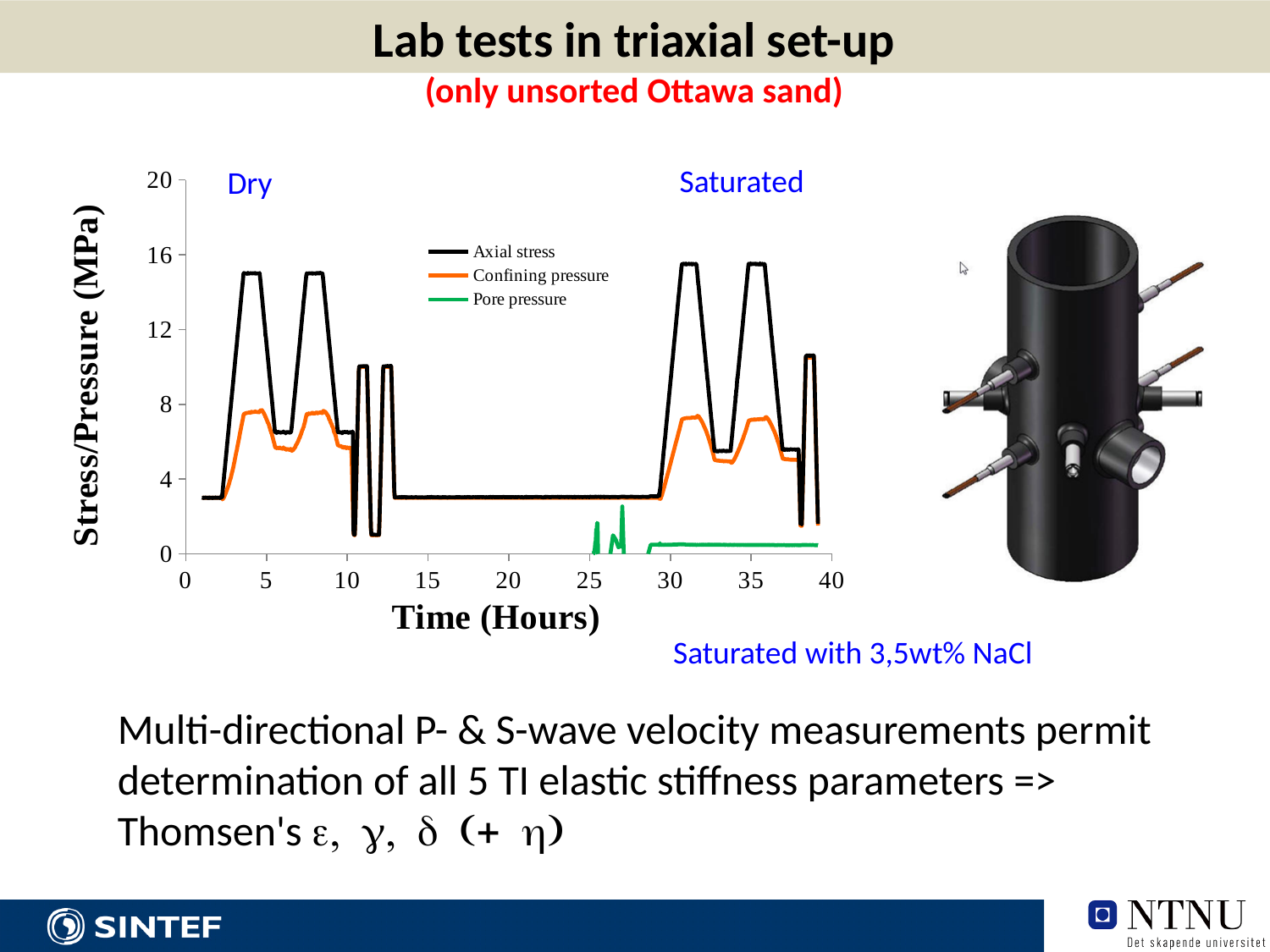
Is the value of Pore pressure at hour 35 greater or less than 4? less Is the peak value of Axial stress near hour 4 greater or less than 12? greater At hour 4, which is larger: Axial stress or Confining pressure? Axial stress Is the peak value of Axial stress near hour 31 greater or less than 12? greater Which series is drawn in green in the chart? Pore pressure How many series does the chart's legend list? 3 What kind of chart is shown on the slide? line chart What is the title of the x axis of the chart? Time (Hours) At hour 35, which is larger: Confining pressure or Pore pressure? Confining pressure Which series reaches the highest value on the chart? Axial stress